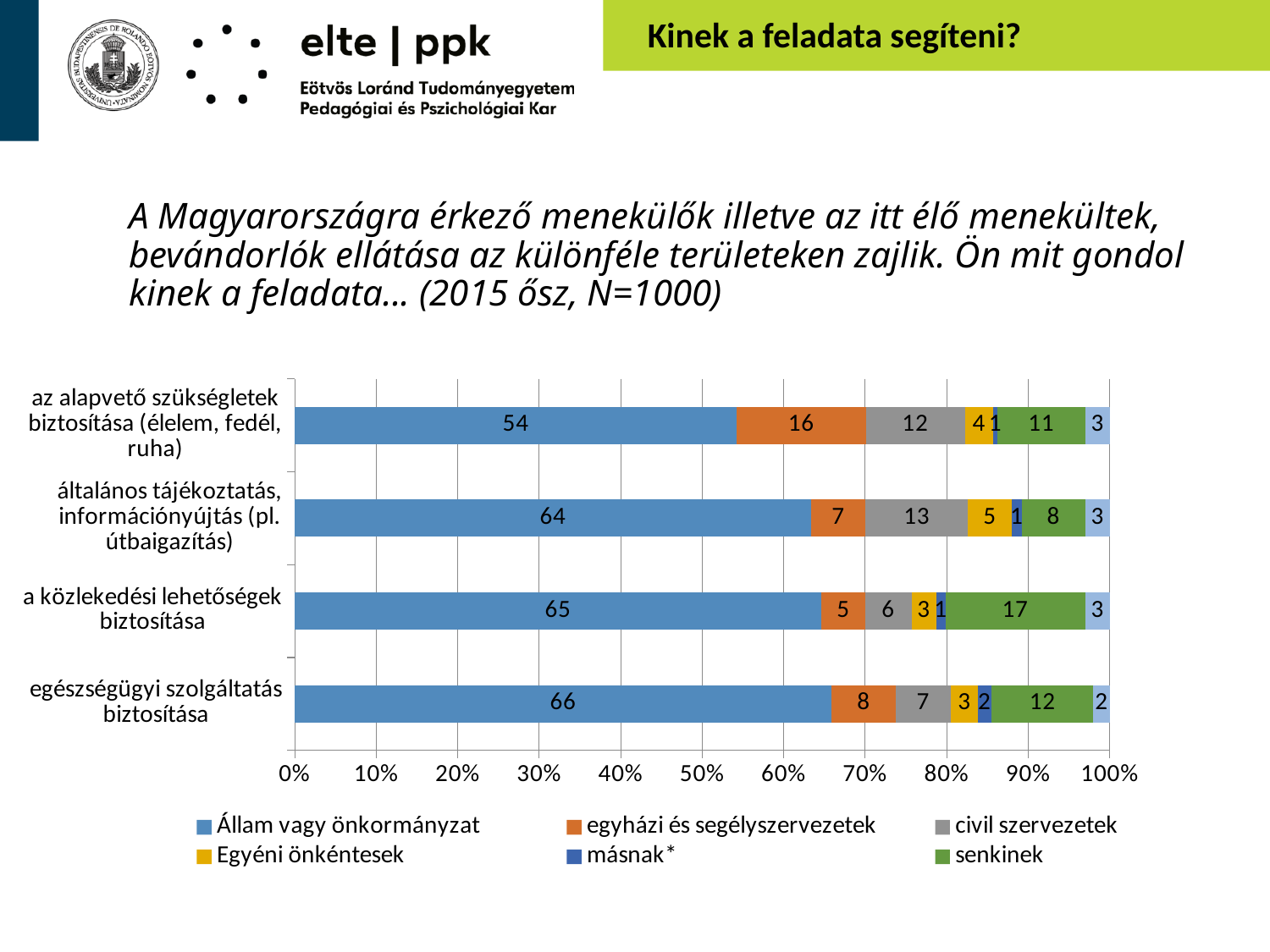
Which category has the lowest value for senkinek? általános tájékoztatás, információnyújtás (pl. útbaigazítás) What is the value of senkinek for a közlekedési lehetőségek biztosítása? 17 Which category has the highest value for Állam vagy önkormányzat? egészségügyi szolgáltatás biztosítása What colour represents senkinek in the legend? green What kind of chart is shown on the slide? stacked bar chart What is the value of egyházi és segélyszervezetek for az alapvető szükségletek biztosítása (élelem, fedél, ruha)? 16 What is the value of Állam vagy önkormányzat for egészségügyi szolgáltatás biztosítása? 66 How many categories are shown on the chart? 4 How many series does the legend list? 6 Which category has the larger egyházi és segélyszervezetek value: az alapvető szükségletek biztosítása or egészségügyi szolgáltatás biztosítása? az alapvető szükségletek biztosítása What is the value of civil szervezetek for általános tájékoztatás, információnyújtás (pl. útbaigazítás)? 13 What is the difference between the Állam vagy önkormányzat values for egészségügyi szolgáltatás biztosítása and az alapvető szükségletek biztosítása? 12